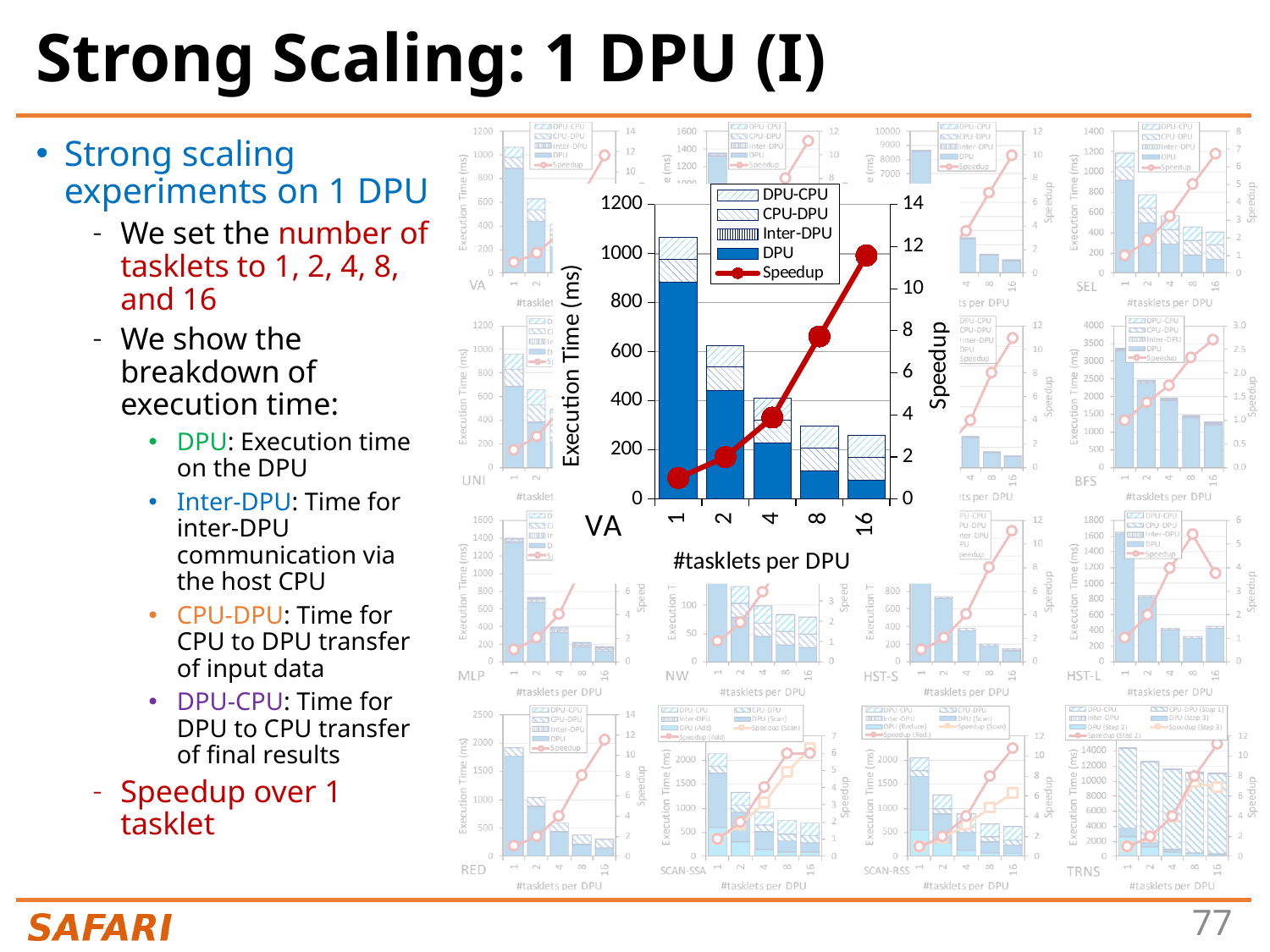
In the enlarged VA chart, does the Speedup line rise or fall as the number of tasklets per DPU increases? rise What is the x-axis label of the enlarged VA chart? #tasklets per DPU In the enlarged VA chart, which number of tasklets per DPU has the highest total execution time? 1 In the enlarged VA chart, which has the larger Speedup: 8 tasklets or 4 tasklets? 8 tasklets In the enlarged VA chart, how many tasklet counts are shown on the x axis? 5 In the enlarged VA chart, is the total execution time for 2 tasklets greater or less than 800 ms? less In the enlarged VA chart, is the total execution time for 1 tasklet greater or less than 1000 ms? greater What kind of chart is the enlarged VA chart in the centre of the slide? bar chart with a line overlay In the enlarged VA chart, is the Speedup for 16 tasklets greater or less than 10? greater In the enlarged VA chart, does the total execution time rise or fall as the number of tasklets per DPU increases? fall In the enlarged VA chart, which number of tasklets per DPU has the lowest total execution time? 16 How many entries does the legend of the enlarged VA chart list? 5